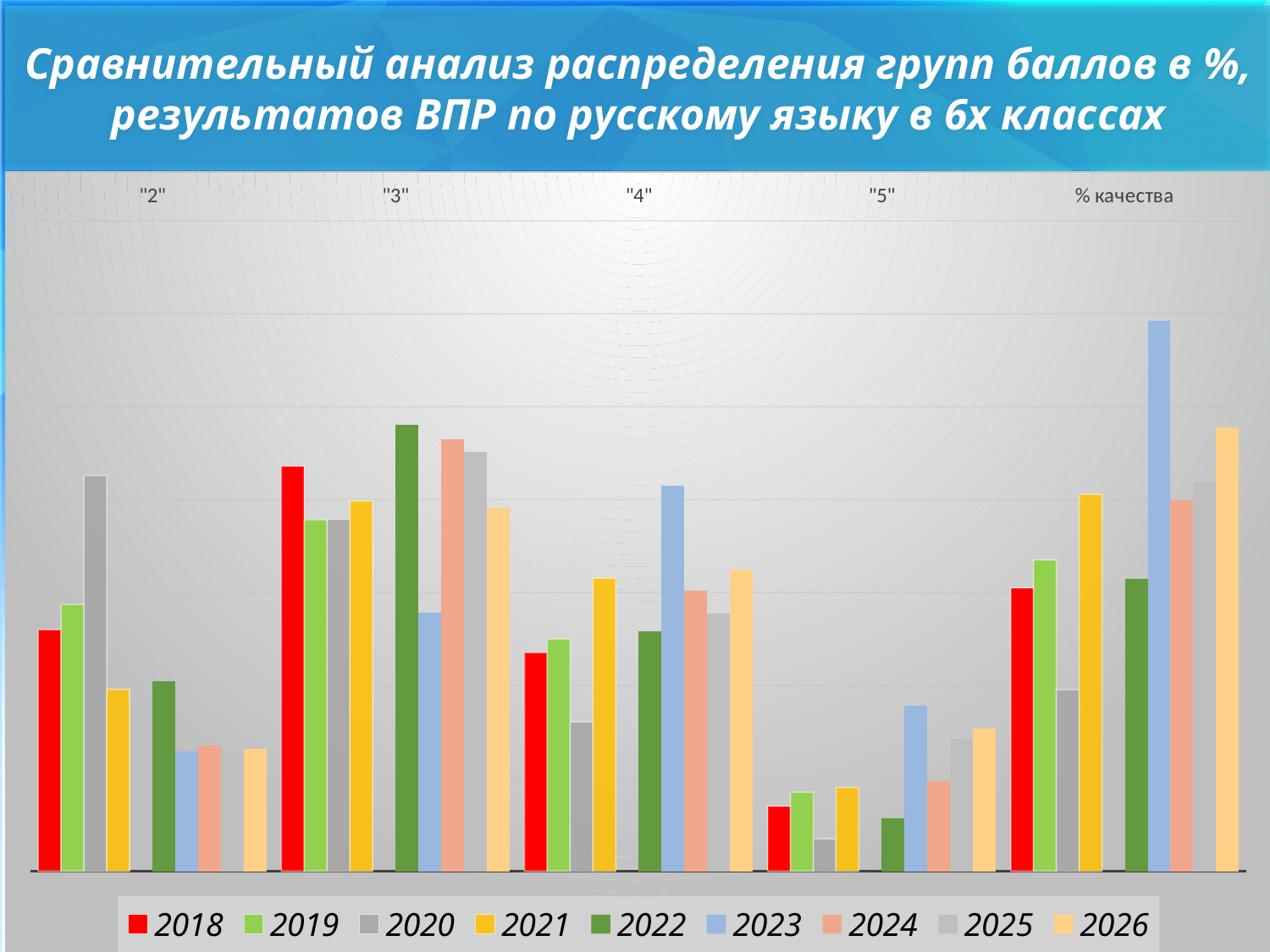
Which year is listed first in the legend? 2018 In the "% качества" category, which year has the highest bar? 2023 How many categories are shown along the x axis? 5 How many series does the legend list? 9 What kind of chart is shown on the slide? bar chart In the "% качества" category, which year has the lowest bar? 2020 In the "4" category, which year has the highest bar? 2023 In the "5" category, which year has the lowest bar? 2020 In the "3" category, which is larger: the bar for 2018 or the bar for 2019? 2018 In the "3" category, which year has the highest bar? 2022 In the "3" category, which year has the lowest bar? 2023